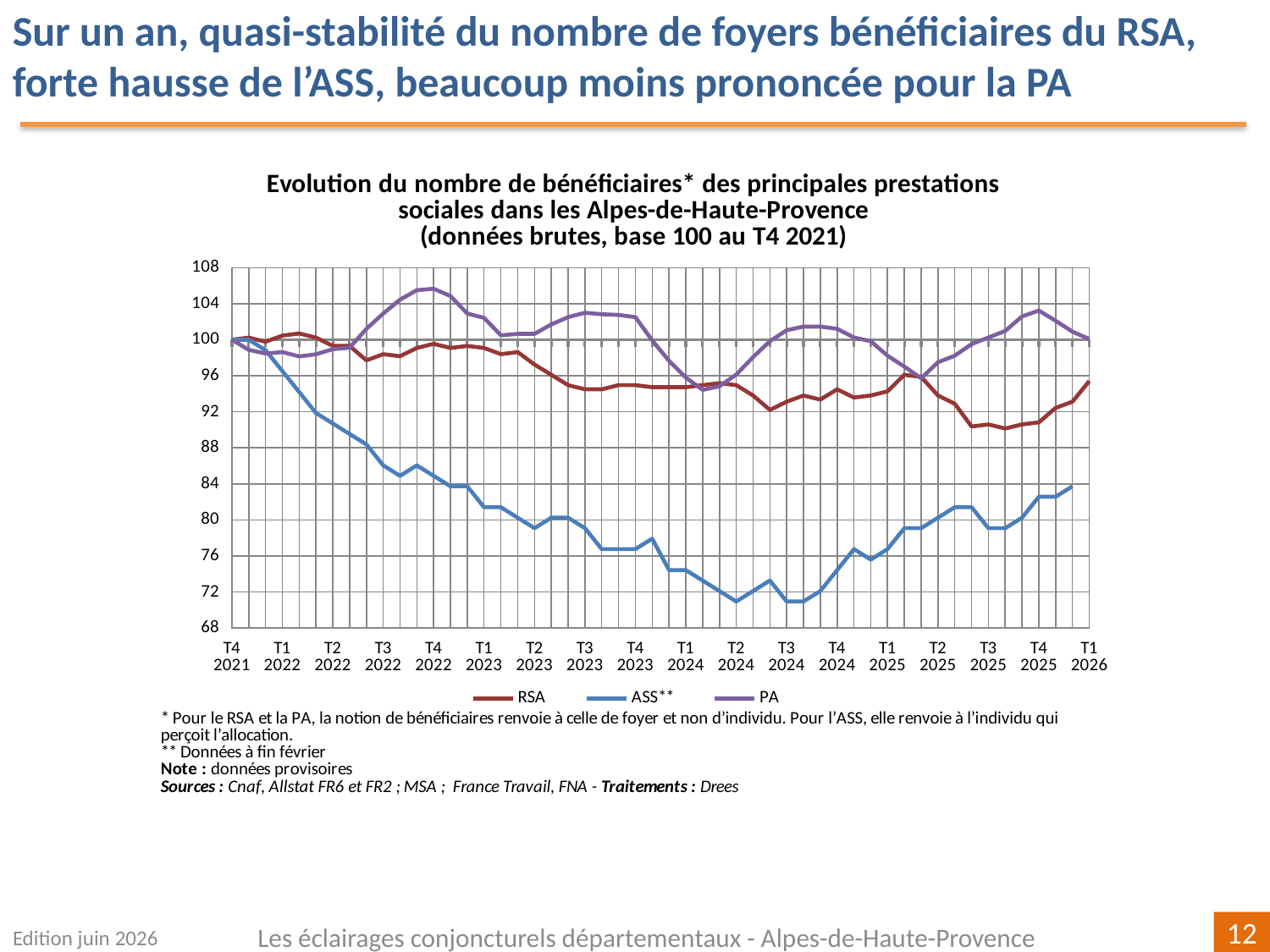
How many series does the legend list? 3 What kind of chart is shown on the slide? line chart Is the value for ASS** at T1 2024 greater or less than 76? less What is the value of the RSA series at T4 2021? 100 Is the value for PA at T4 2022 greater or less than 104? greater Which series are listed in the legend? RSA, ASS**, PA Does the ASS** series rise or fall between T4 2021 and T2 2024? fall How many quarter labels are shown along the x axis? 18 Is the value for RSA at T3 2025 greater or less than 92? less